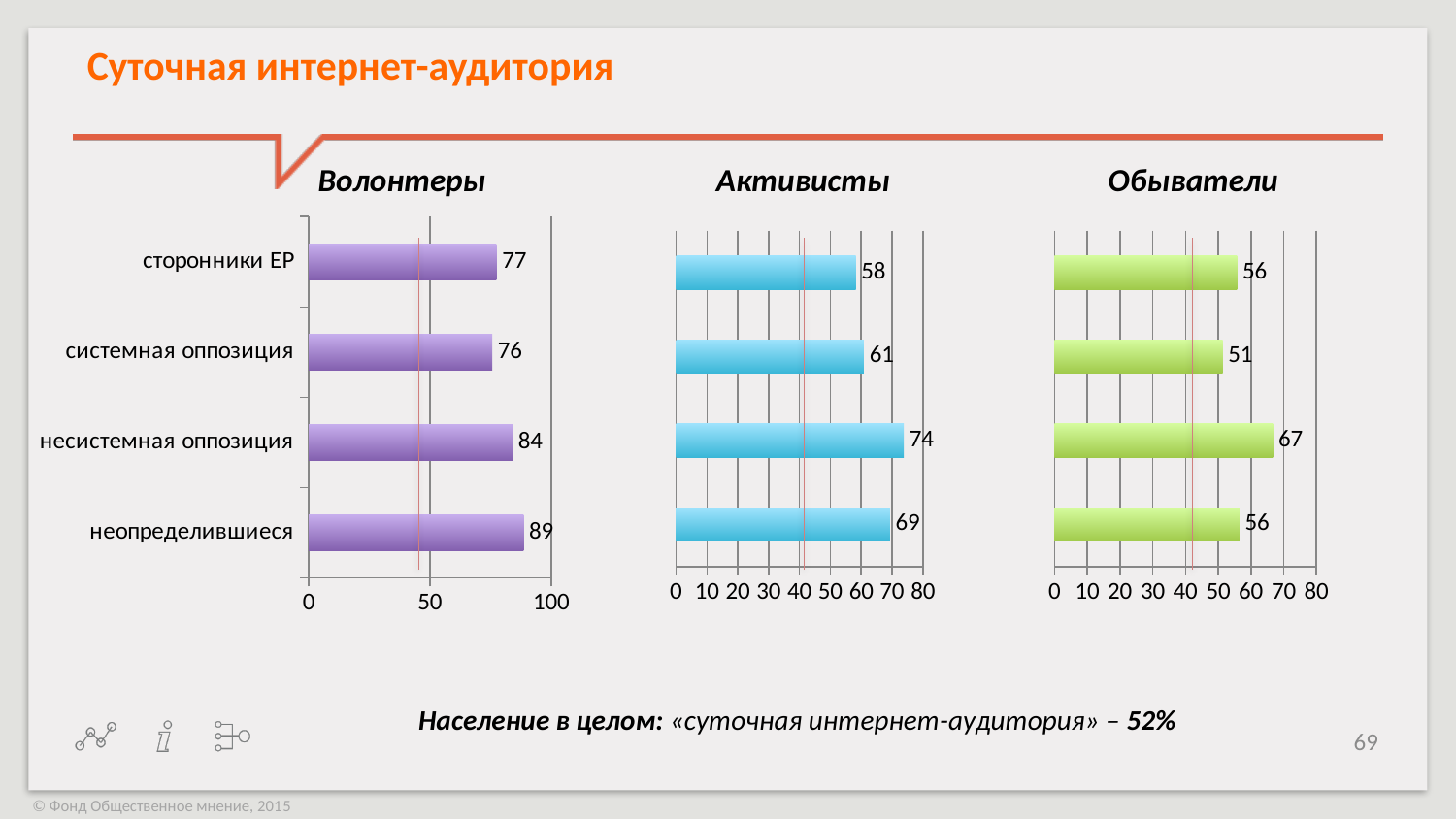
In the 'Обыватели' chart, what is the difference between the values for 'несистемная оппозиция' and 'системная оппозиция'? 16 In the 'Волонтеры' chart, what is the value for 'неопределившиеся'? 89 How many categories are shown in the 'Активисты' chart? 4 In the 'Активисты' chart, what is the value for 'несистемная оппозиция'? 74 In the 'Активисты' chart, what is the difference between the values for 'несистемная оппозиция' and 'сторонники ЕР'? 16 In the 'Обыватели' chart, which category has the highest value? несистемная оппозиция What is the title of the slide? Суточная интернет-аудитория What type of chart is the 'Обыватели' chart? bar chart In the 'Обыватели' chart, what is the value for 'системная оппозиция'? 51 In the 'Волонтеры' chart, which is larger: the value for 'несистемная оппозиция' or the value for 'системная оппозиция'? несистемная оппозиция In the 'Волонтеры' chart, which category has the highest value? неопределившиеся In the 'Активисты' chart, which category has the lowest value? сторонники ЕР